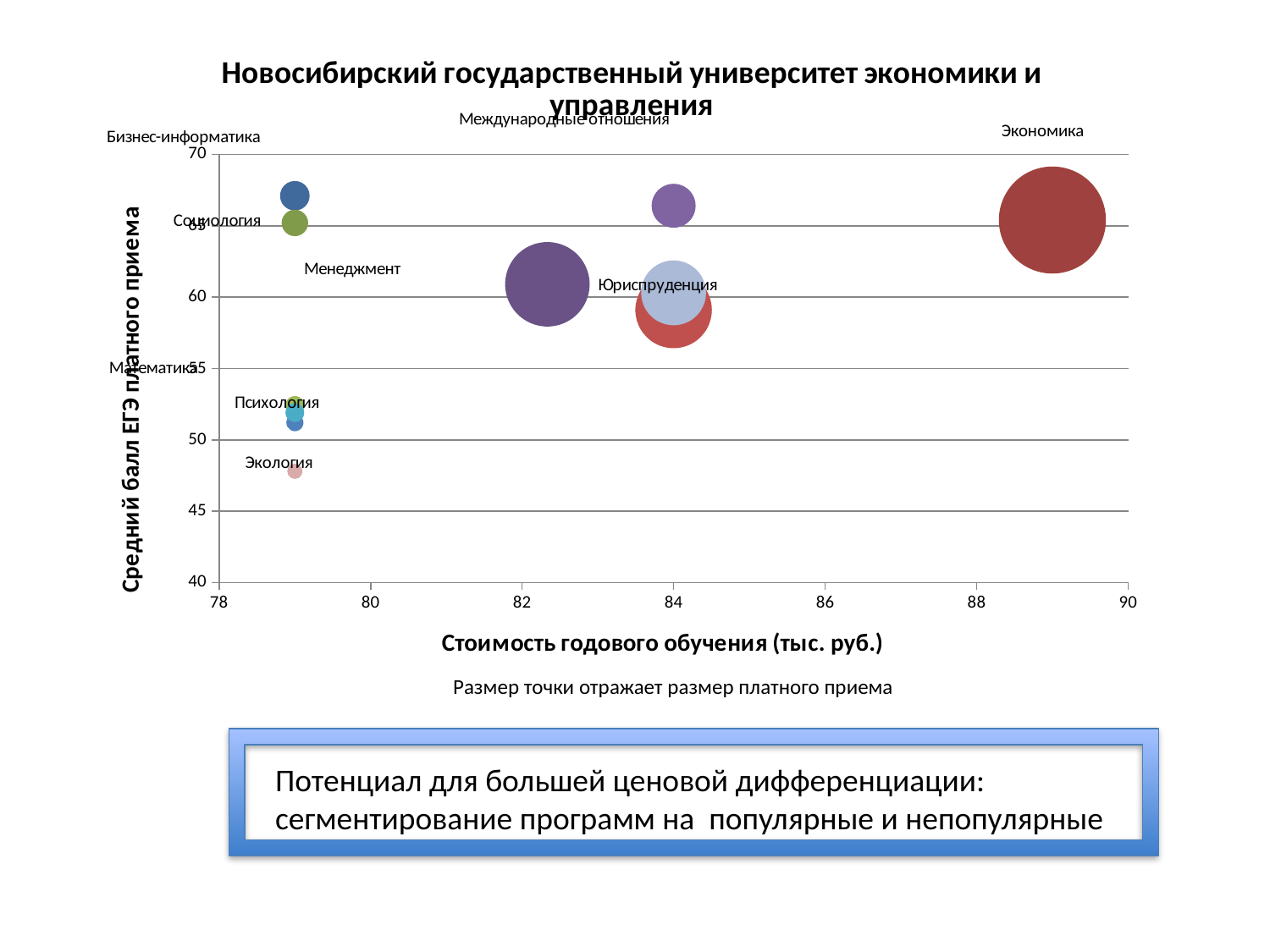
What kind of chart is shown on the slide? Bubble chart Which program has the highest annual tuition cost (furthest right on the x axis)? Экономика What is the title of the x axis? Стоимость годового обучения (тыс. руб.) Is the annual tuition cost for Экономика greater or less than 88 thousand rubles? greater Is the average ЕГЭ score for Экология greater or less than 50? less According to the note under the chart, what does the size of a point reflect? Размер платного приема Which program has a higher average ЕГЭ score, Бизнес-информатика or Экология? Бизнес-информатика Which program has a higher annual tuition cost, Экономика or Менеджмент? Экономика Is the annual tuition cost for Менеджмент greater or less than 80 thousand rubles? greater Which program has the lowest average ЕГЭ score (lowest on the y axis)? Экология